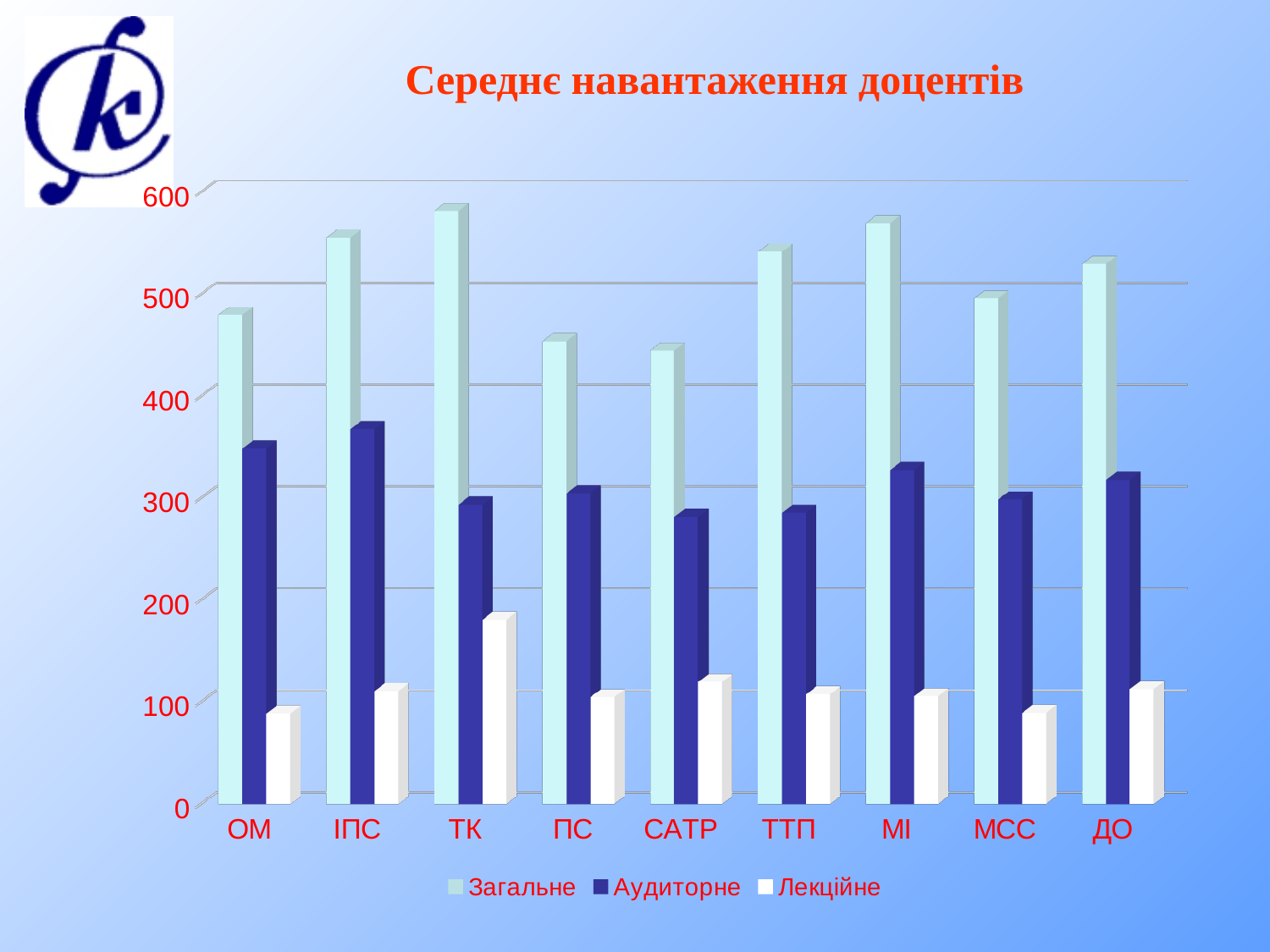
How many series does the legend list? 3 Which category has the highest Загальне value? ТК Which category has the highest Лекційне value? ТК Is the Лекційне value for ТК greater or less than 100? greater Which is larger, the Загальне value for ІПС or for ПС? ІПС Which category has the highest Аудиторне value? ІПС What is the title of the chart? Середнє навантаження доцентів Is the Аудиторне value for САТР greater or less than 300? less Is the Загальне value for ТК greater or less than 500? greater Which series is shown in white bars according to the legend? Лекційне How many categories are shown on the x axis? 9 What kind of chart is shown on the slide? bar chart